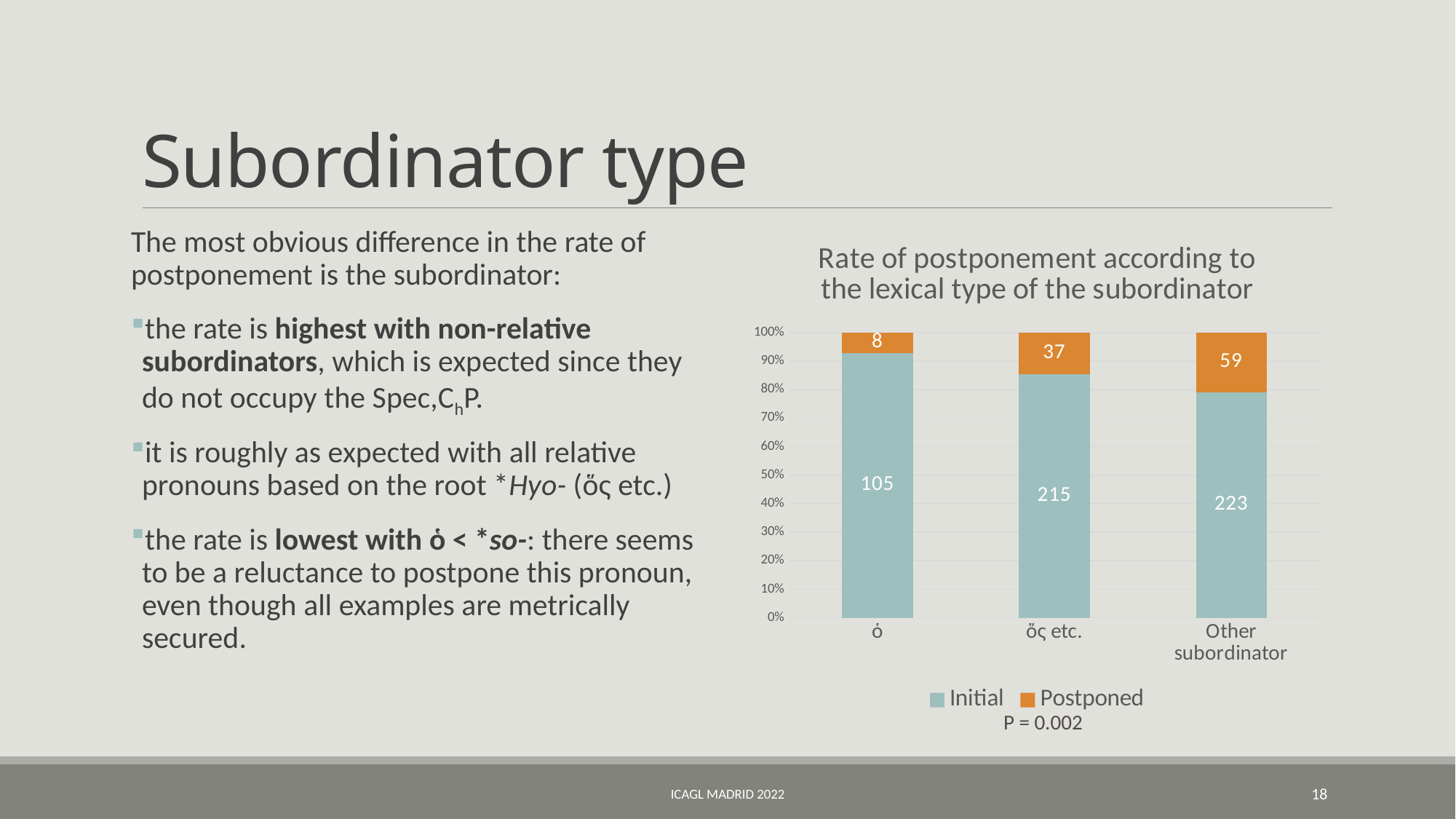
Is the Initial share of the ὅς etc. bar greater or less than 80%? greater What is the Initial value for ὅς etc.? 215 Which category has the lowest Initial value? ὁ What is the Postponed value for Other subordinator? 59 How many series does the chart legend list? 2 Which category has the highest Postponed value? Other subordinator What is the title of the chart? Rate of postponement according to the lexical type of the subordinator What is the total of the two labelled values in the ὅς etc. bar? 252 What kind of chart is shown on the slide? stacked bar chart How many categories are shown on the x axis of the chart? 3 What is the difference between the Initial values for Other subordinator and ὅς etc.? 8 What is the Postponed value for ὁ? 8